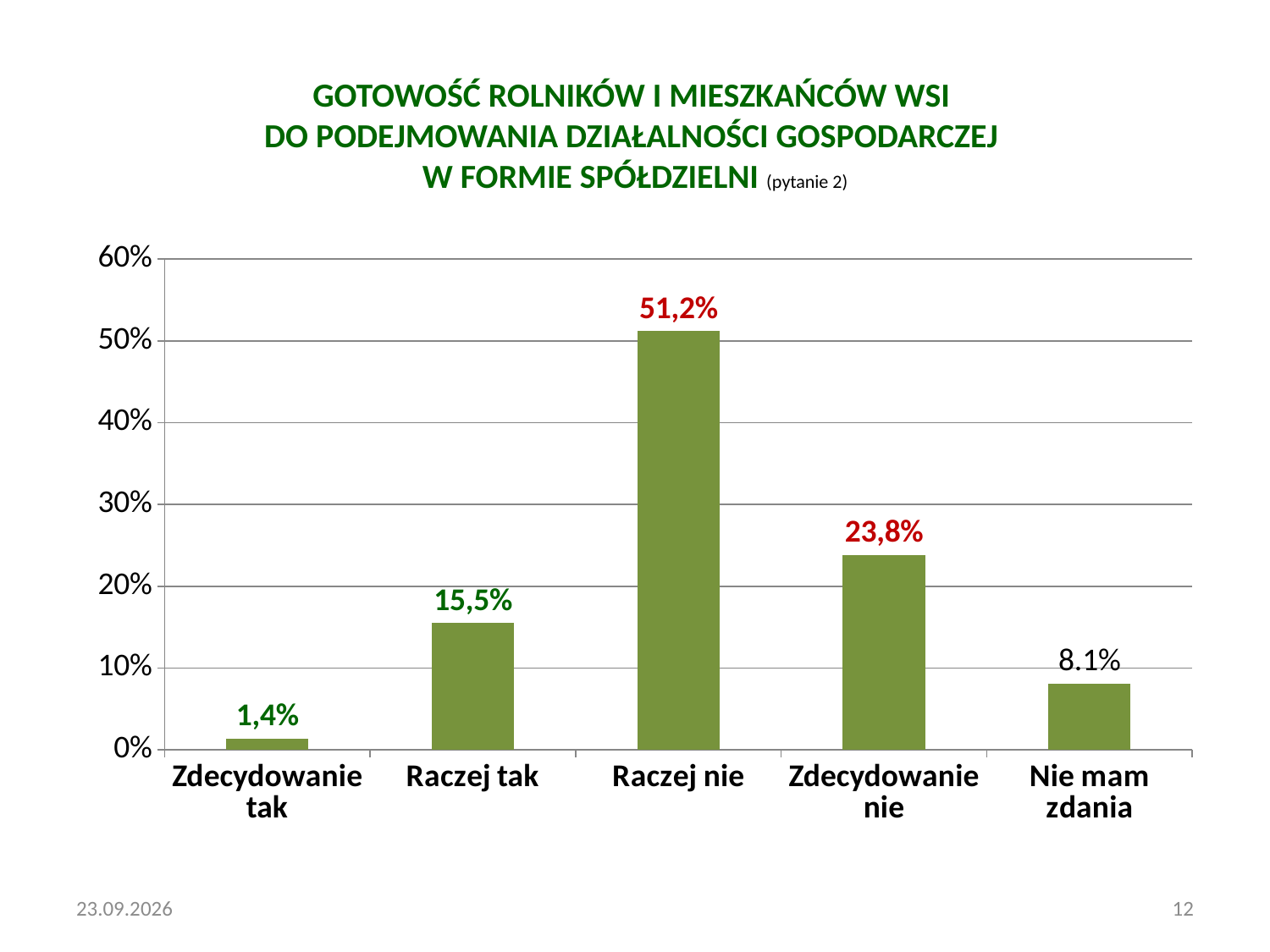
Is the value for "Raczej nie" greater or less than 50%? greater What is the difference between the values for "Raczej tak" and "Zdecydowanie tak"? 14,1% Which is larger, the value for "Raczej tak" or the value for "Zdecydowanie nie"? Zdecydowanie nie What is the highest value shown on the vertical axis? 60% What is the value for "Raczej nie"? 51,2% How many categories are shown on the x axis? 5 Which category has the lowest value? Zdecydowanie tak What kind of chart is shown on the slide? bar chart What is the value for "Zdecydowanie tak"? 1,4% Which category has the highest value? Raczej nie What is the value for "Nie mam zdania"? 8.1% What is the difference between the values for "Raczej nie" and "Zdecydowanie nie"? 27,4%